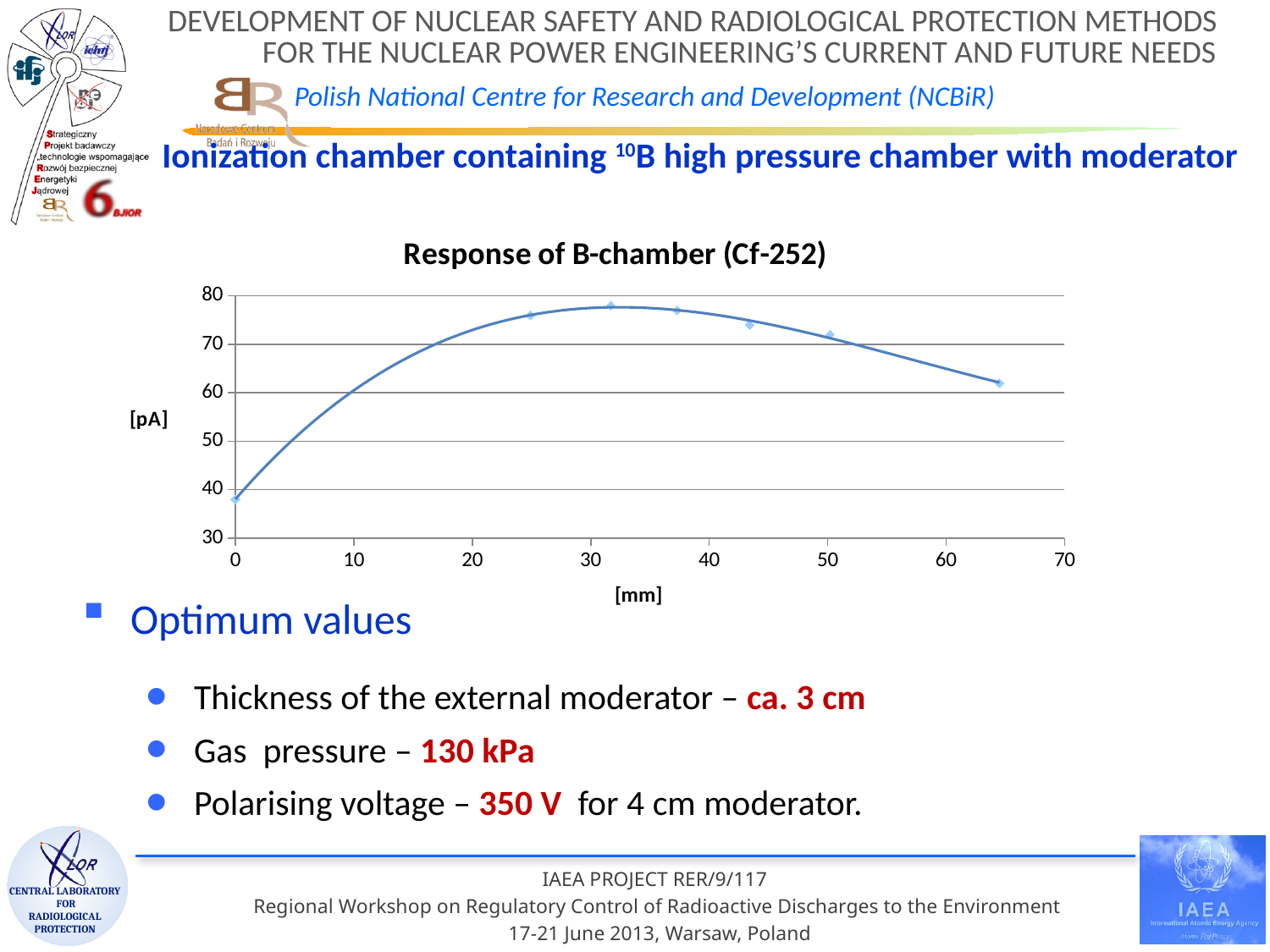
What unit is shown on the y axis of the chart? [pA] What is the title of the chart? Response of B-chamber (Cf-252) Is the value at about 64 mm greater or less than 70 pA? less Is the value at about 25 mm greater or less than 70 pA? greater Is the value at about 50 mm greater or less than 60 pA? greater What is the maximum value shown on the y axis? 80 Which is larger, the value at 0 mm or the value at about 64 mm? the value at about 64 mm Which plotted point has the lowest value? the point at 0 mm How do the values change as the x axis increases from 0 to 70 mm? they rise to a peak around 30 mm and then fall What kind of chart is shown on the slide? line chart (scatter with smooth line) How many data points are plotted on the chart? 7